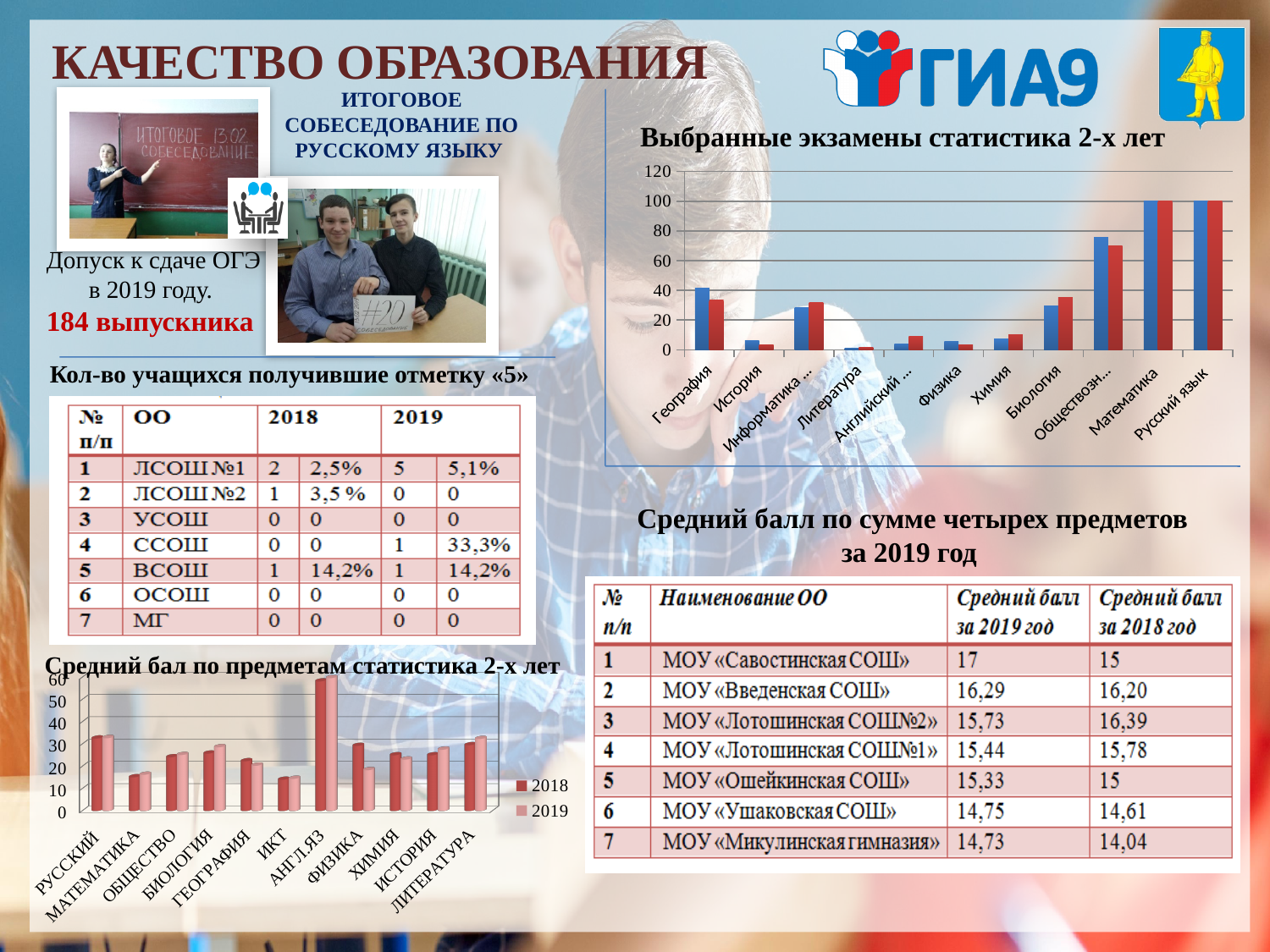
In the chart 'Выбранные экзамены статистика 2-х лет', is the blue bar for Обществозн... greater or less than 60? greater In the chart 'Выбранные экзамены статистика 2-х лет', is the value for Литература greater or less than 20? less In the chart 'Средний бал по предметам статистика 2-х лет', is the 2018 value for АНГЛ.ЯЗ greater or less than 50? greater In the chart 'Средний бал по предметам статистика 2-х лет', which subject has the highest bar? АНГЛ.ЯЗ In the chart 'Выбранные экзамены статистика 2-х лет', what value do both bars for Русский язык reach? 100 In the chart 'Выбранные экзамены статистика 2-х лет', how many subject categories are shown on the x axis? 11 In the chart 'Выбранные экзамены статистика 2-х лет', what value do both bars for Математика reach? 100 In the chart 'Средний бал по предметам статистика 2-х лет', what are the legend entries? 2018, 2019 In the chart 'Выбранные экзамены статистика 2-х лет', which is larger: the blue bar for География or the blue bar for Физика? География In the chart 'Средний бал по предметам статистика 2-х лет', how many series does the legend list? 2 In the chart 'Выбранные экзамены статистика 2-х лет', what kind of chart is shown? bar chart In the chart 'Средний бал по предметам статистика 2-х лет', how many subject categories are shown on the x axis? 11